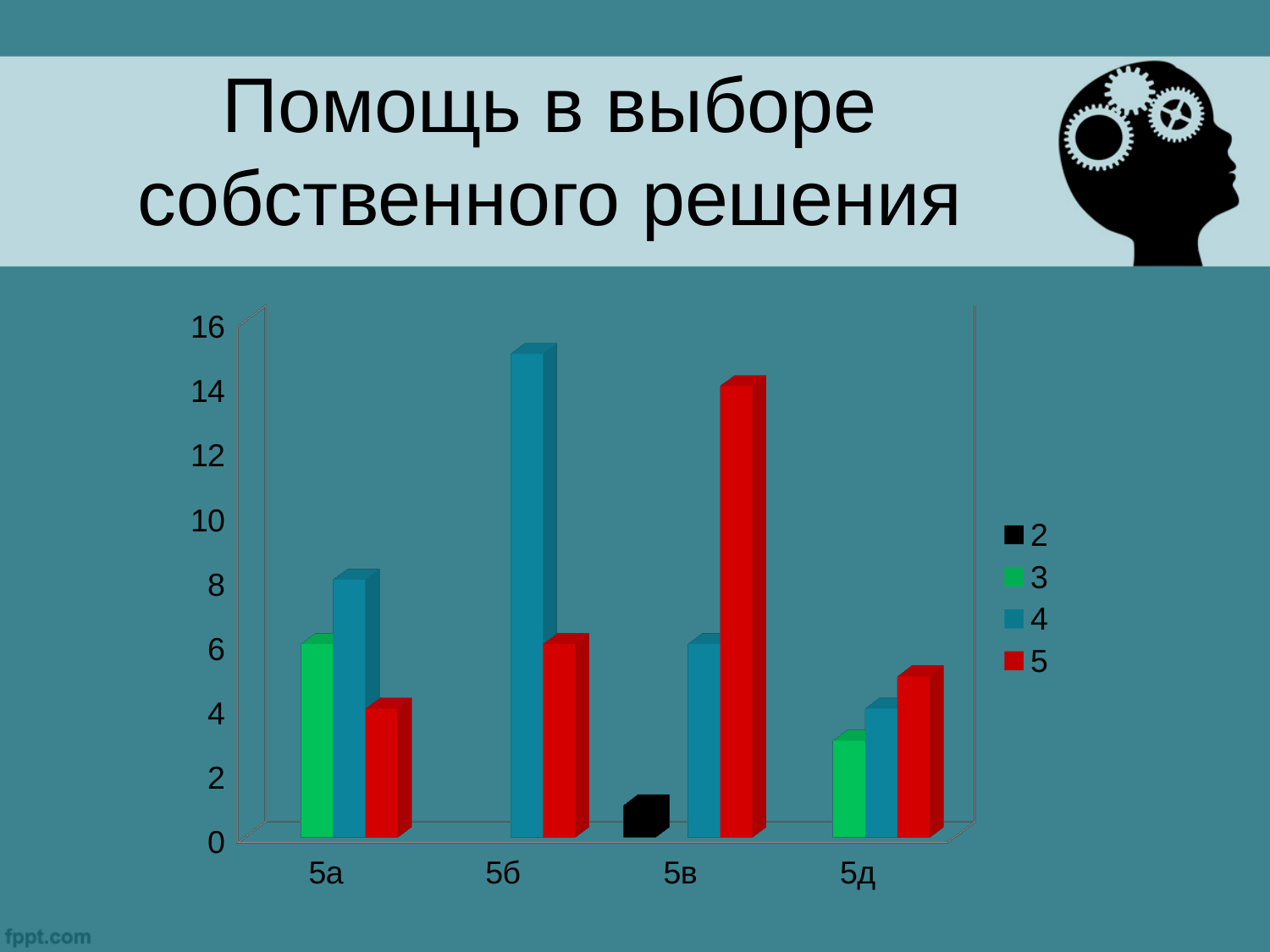
How many categories are shown on the x axis of the chart? 4 What are the legend entries of the chart? 2, 3, 4, 5 Is the value of series 3 for category 5д greater or less than 4? less Is the value of series 4 for category 5б greater or less than 14? greater What kind of chart is shown on the slide? bar chart For category 5а, which is larger: the value of series 3 or the value of series 5? series 3 What is the value of series 4 for category 5а? 8 How many series does the chart's legend list? 4 What is the value of series 5 for category 5в? 14 Which category has the lowest value for series 4? 5д Which category has the highest value for series 5? 5в Is the value of series 2 for category 5в greater or less than 2? less